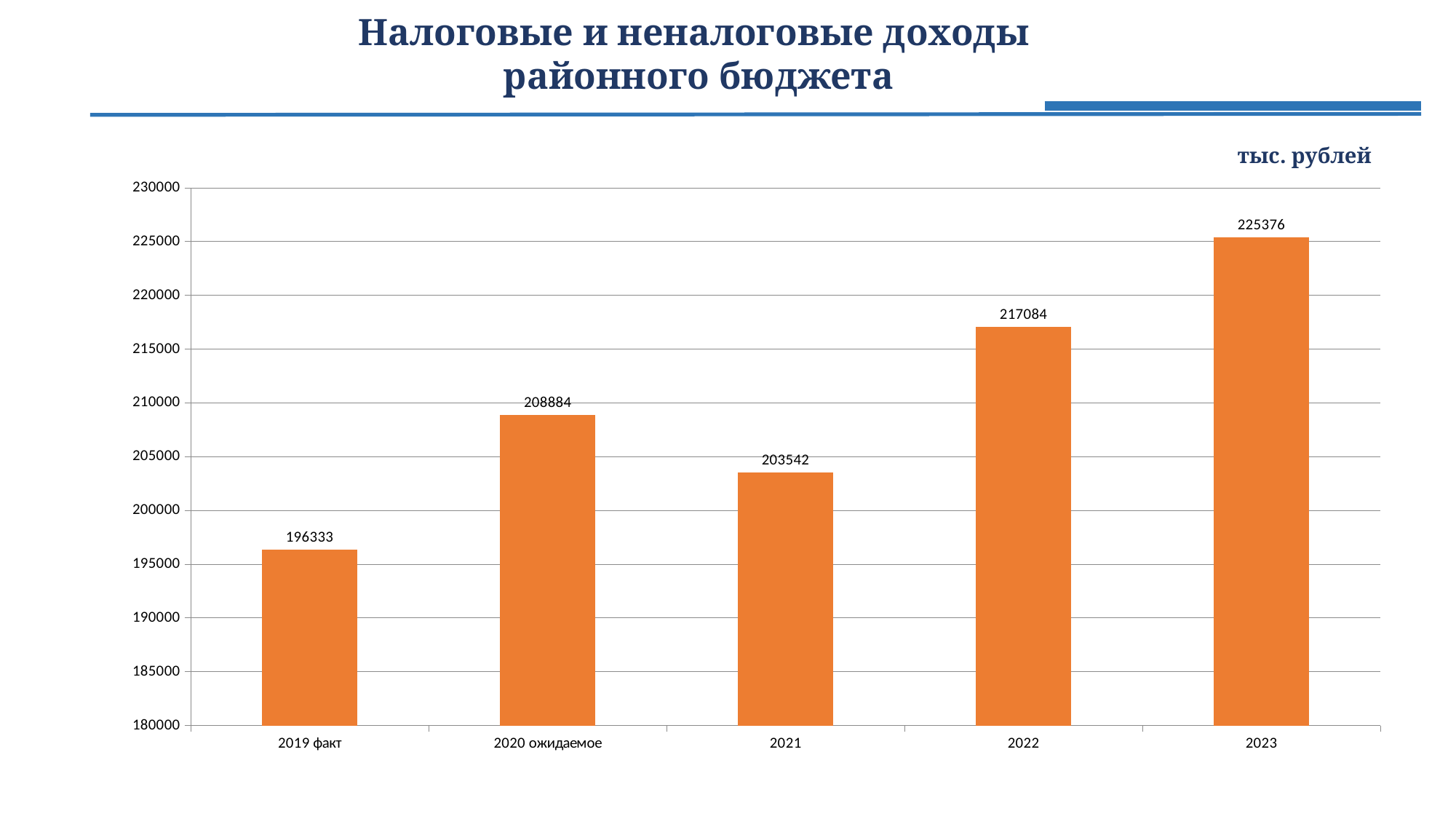
What is the difference between the values for 2023 and 2022? 8292 Which category has the lowest value? 2019 факт What is the value for 2020 ожидаемое? 208884 What is the value for 2019 факт? 196333 What is the value for 2021? 203542 What kind of chart is shown on the slide? bar chart Which is larger, the value for 2020 ожидаемое or the value for 2021? 2020 ожидаемое Is the value for 2022 greater or less than 215000? greater What is the value for 2023? 225376 Which category has the highest value? 2023 What unit is indicated above the chart? тыс. рублей How many categories are shown on the x axis? 5